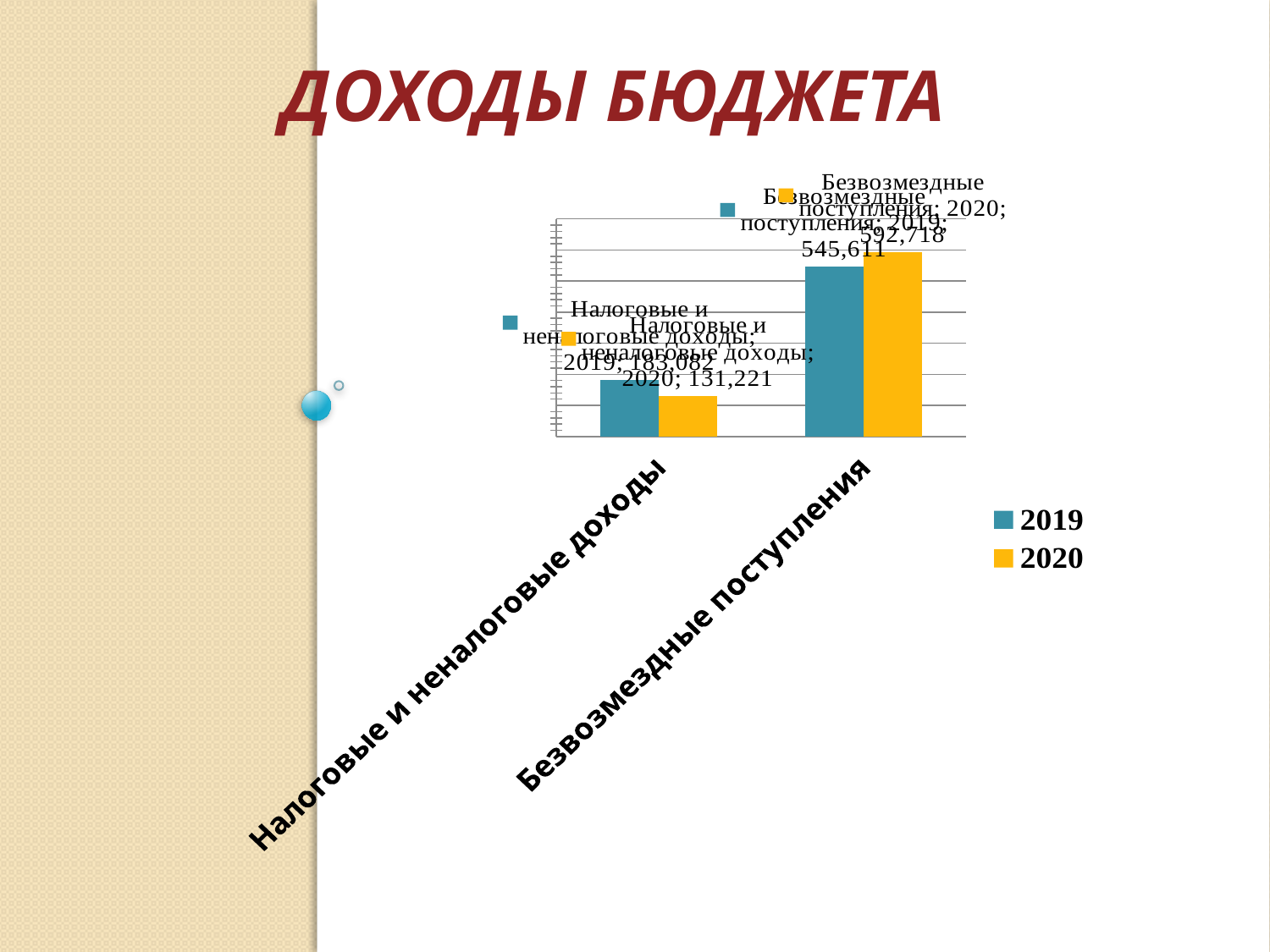
What is the 2020 value for Налоговые и неналоговые доходы? 131,221 What is the 2020 value for Безвозмездные поступления? 592,718 What type of chart is shown on the slide? Bar chart For Налоговые и неналоговые доходы, which year has the larger value, 2019 or 2020? 2019 How many series does the legend list? 2 What is the difference between the 2019 and 2020 values for Налоговые и неналоговые доходы? 51,861 Which category has the lowest 2019 value? Налоговые и неналоговые доходы What is the 2019 value for Безвозмездные поступления? 545,611 Which category has the highest 2020 value? Безвозмездные поступления For Безвозмездные поступления, which year has the larger value, 2019 or 2020? 2020 How many categories are shown on the x axis? 2 What is the 2019 value for Налоговые и неналоговые доходы? 183,082